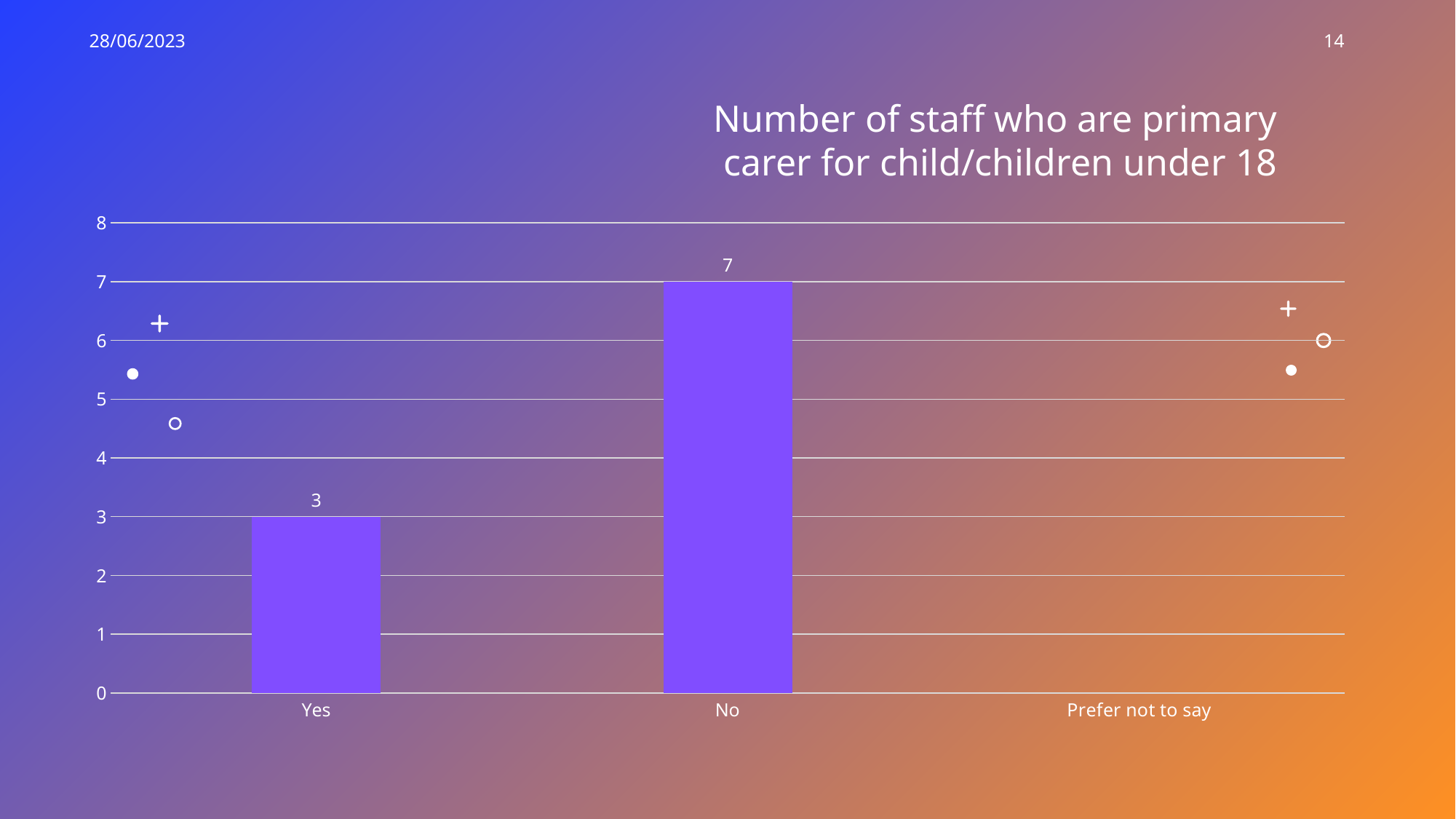
Is the value for No greater or less than 5? greater What is the difference between the values for No and Yes? 4 How many categories are shown on the x axis? 3 Which category has no visible bar? Prefer not to say What is the value for No? 7 What is the value for Yes? 3 Which category has the highest value? No Which is larger, the value for Yes or the value for No? No What is the highest value shown on the vertical axis? 8 Is the value for Yes greater or less than 4? less What kind of chart is shown on the slide? bar chart What is the title of the chart? Number of staff who are primary carer for child/children under 18